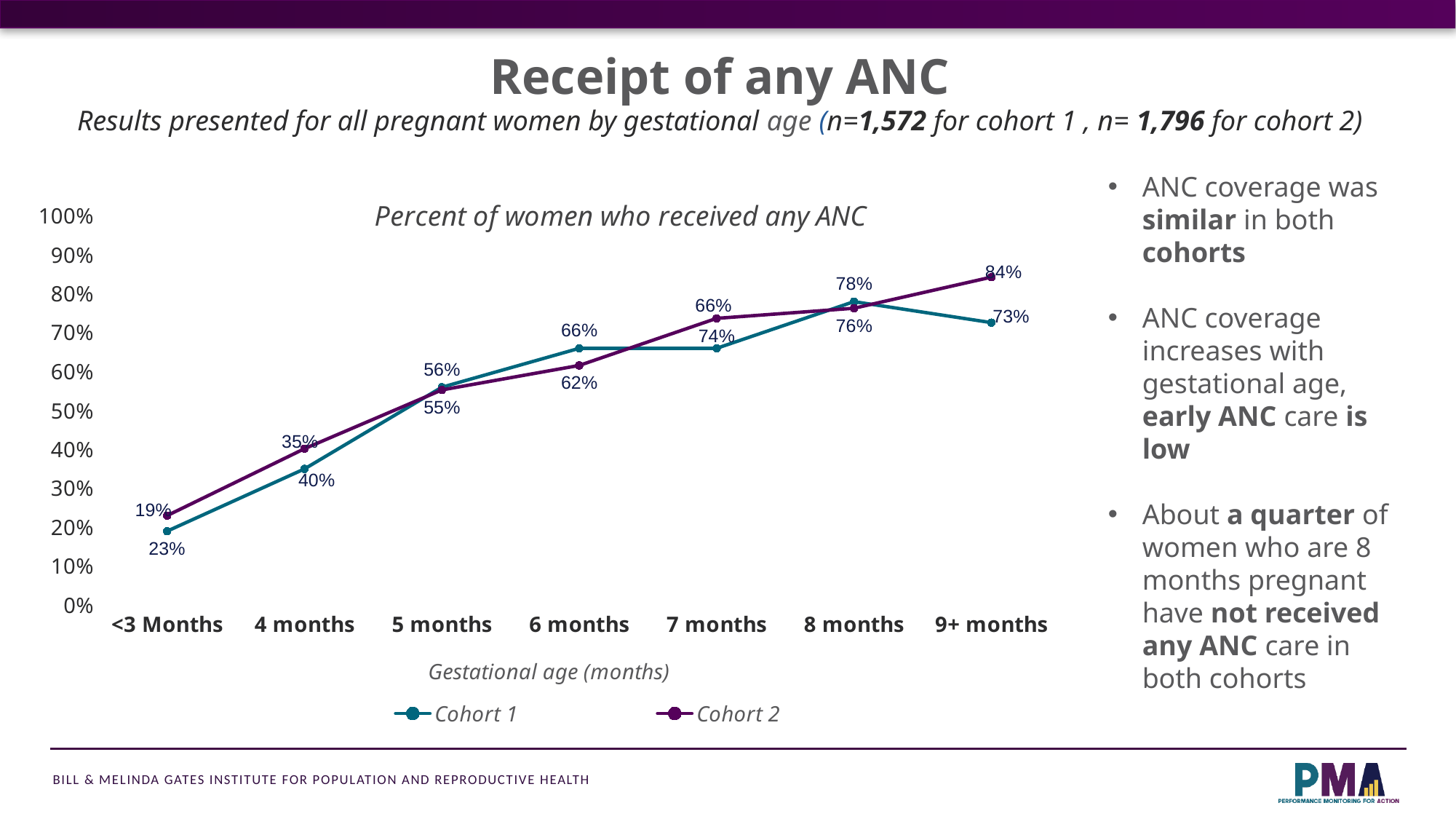
What is the difference between Cohort 2 and Cohort 1 at 9+ months? 11 percentage points Does the Cohort 2 line rise or fall as gestational age increases? Rises How many series does the legend list? 2 What is the title of the chart? Percent of women who received any ANC What is the value for Cohort 1 at 9+ months? 73% At which gestational age is the Cohort 2 value highest? 9+ months At which gestational age is the Cohort 1 value lowest? <3 Months What is the value for Cohort 1 at 8 months? 78% What kind of chart is shown on the slide? Line chart At 7 months, which cohort has the higher value? Cohort 2 How many gestational age categories are plotted on the x axis? 7 What is the value for Cohort 2 at 9+ months? 84%